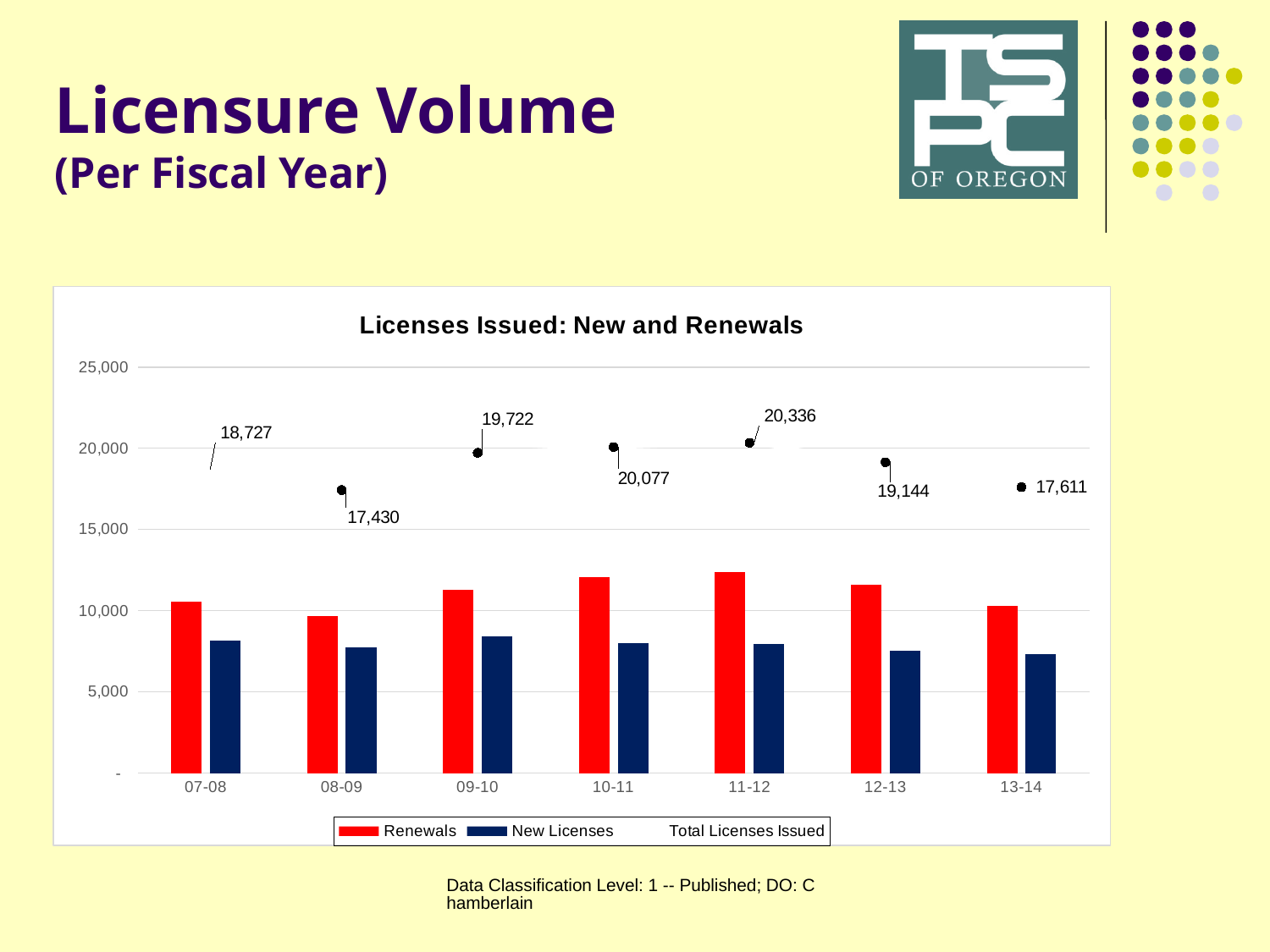
Is the Renewals value for 11-12 greater or less than 10,000? greater What is the Total Licenses Issued value for fiscal year 13-14? 17,611 What is the Total Licenses Issued value for fiscal year 08-09? 17,430 Which fiscal year has the highest Total Licenses Issued? 11-12 Is the New Licenses value for 13-14 greater or less than 10,000? less What is the difference between Total Licenses Issued in 11-12 and in 08-09? 2,906 Which is larger, Total Licenses Issued in 09-10 or in 12-13? 09-10 How many series does the legend list? 3 Which fiscal year has the lowest Total Licenses Issued? 08-09 What is the title of the chart? Licenses Issued: New and Renewals How many fiscal years are shown on the x axis? 7 What is the Total Licenses Issued value for fiscal year 11-12? 20,336